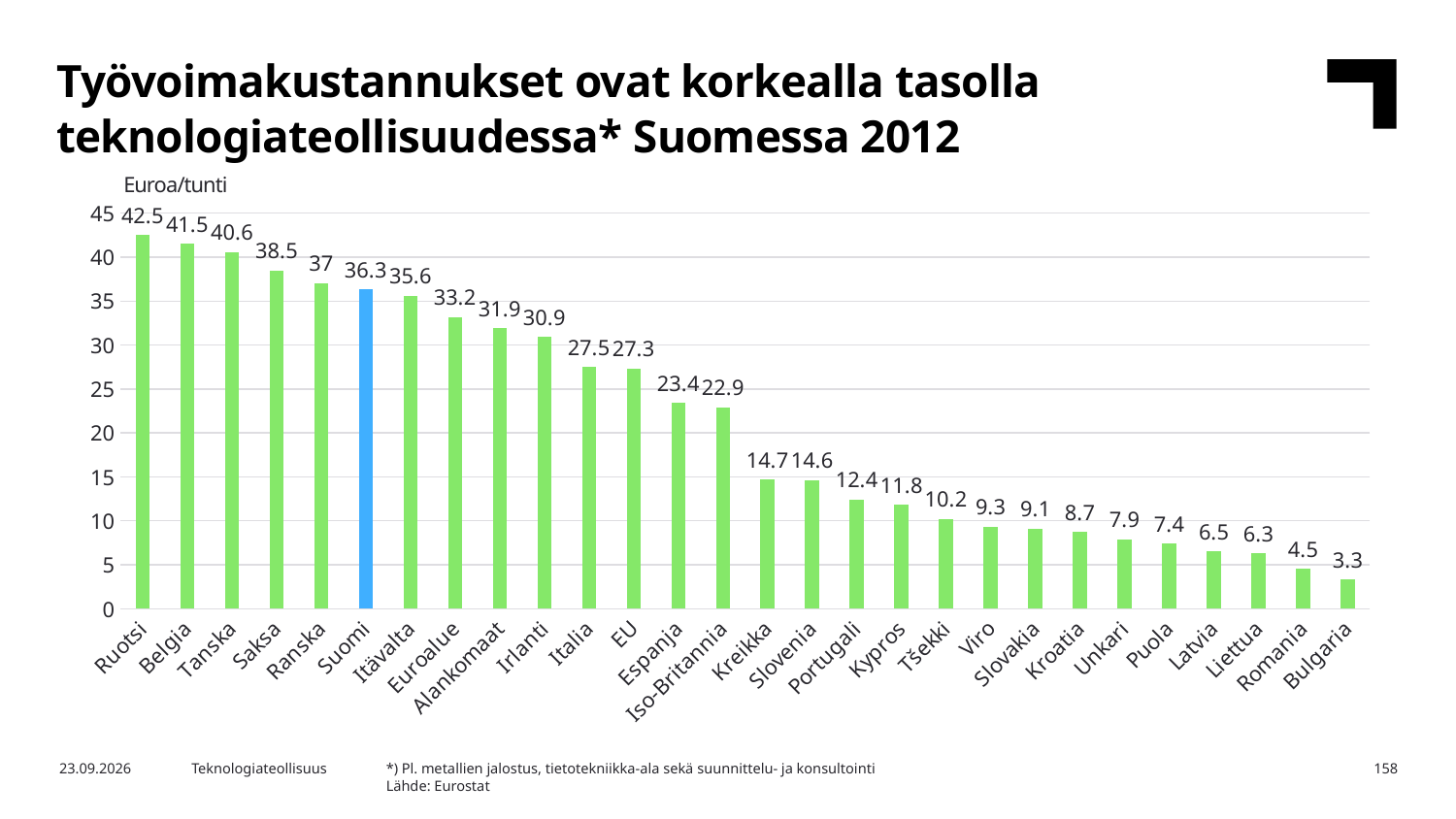
What is the value for Kypros? 11.8 What unit is shown above the vertical axis? Euroa/tunti Is the value for Espanja greater or less than 25? less Which country has the highest labour cost per hour? Ruotsi What kind of chart is shown on the slide? Bar chart Which is larger, the value for Saksa or the value for Itävalta? Saksa Which country has the lowest labour cost per hour? Bulgaria What is the difference between the values for EU and Euroalue? 5.9 What is the value for Alankomaat? 31.9 How many countries or regions are shown on the chart? 28 What is the difference between the values for Ruotsi and Suomi? 6.2 What is the value for Suomi? 36.3